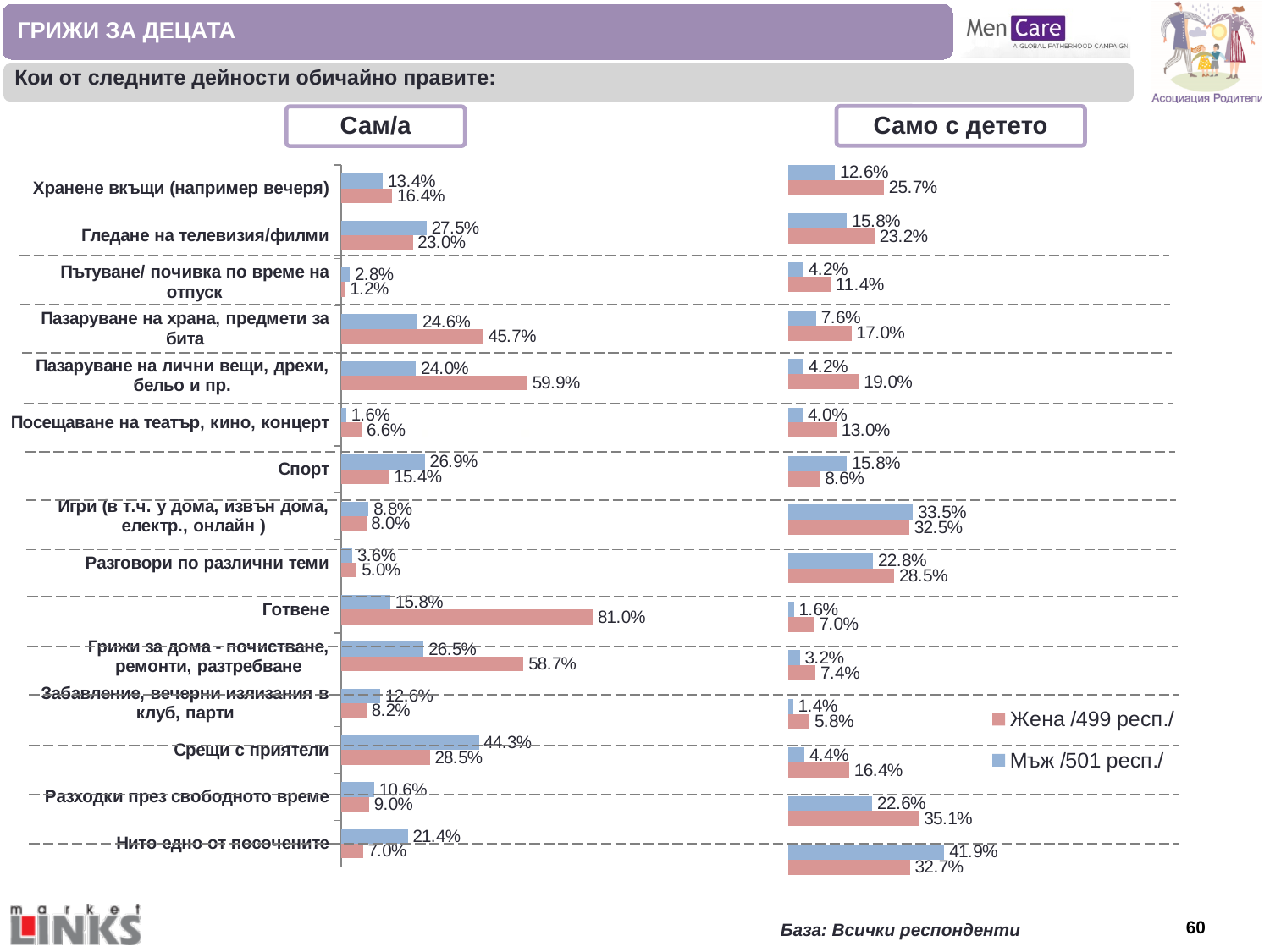
In the 'Сам/а' chart, what is the difference between the Жена and Мъж values for Пазаруване на лични вещи, дрехи, бельо и пр.? 35.9% In the 'Само с детето' chart, what is the difference between the Мъж and Жена values for Нито едно от посочените? 9.2% In the 'Само с детето' chart, which category has the highest value for Жена? Разходки през свободното време In the 'Сам/а' chart, which category has the highest value for Мъж? Срещи с приятели In the 'Сам/а' chart, what is the value for Жена for Готвене? 81.0% In the 'Само с детето' chart, what is the value for Мъж for Игри (в т.ч. у дома, извън дома, електр., онлайн)? 33.5% In the 'Само с детето' chart, which category has the lowest value for Мъж? Забавление, вечерни излизания в клуб, парти How many categories are shown in the 'Сам/а' chart? 15 In the 'Сам/а' chart, which category has the lowest value for Жена? Пътуване/ почивка по време на отпуск In the 'Само с детето' chart, which is larger for Срещи с приятели: the Мъж value or the Жена value? Жена In the 'Сам/а' chart, which is larger for Спорт: the Мъж value or the Жена value? Мъж How many series does the legend list for the charts? 2